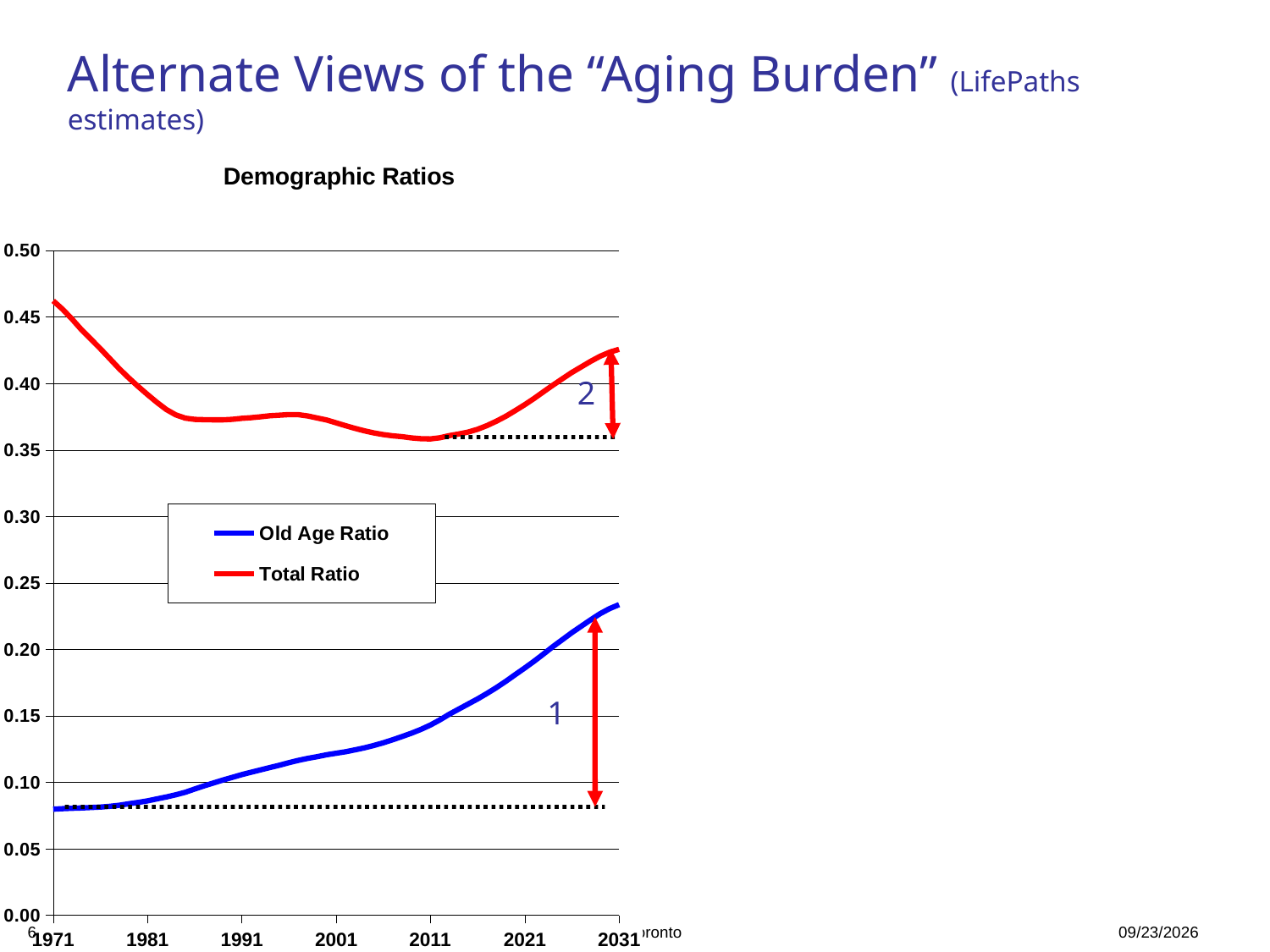
What is the title of the chart? Demographic Ratios How many series does the legend list? 2 How many year labels are shown on the x axis? 7 Is the Old Age Ratio in 2031 greater or less than 0.20? greater In which labelled year is the Total Ratio at its highest? 1971 In 2031, which series is higher, Total Ratio or Old Age Ratio? Total Ratio Does the Old Age Ratio rise or fall from 1971 to 2031? rise Is the Total Ratio in 1971 greater or less than 0.40? greater Is the Old Age Ratio in 1971 greater or less than 0.10? less Which colour is used for the Old Age Ratio line? blue What kind of chart is shown on the slide? line chart